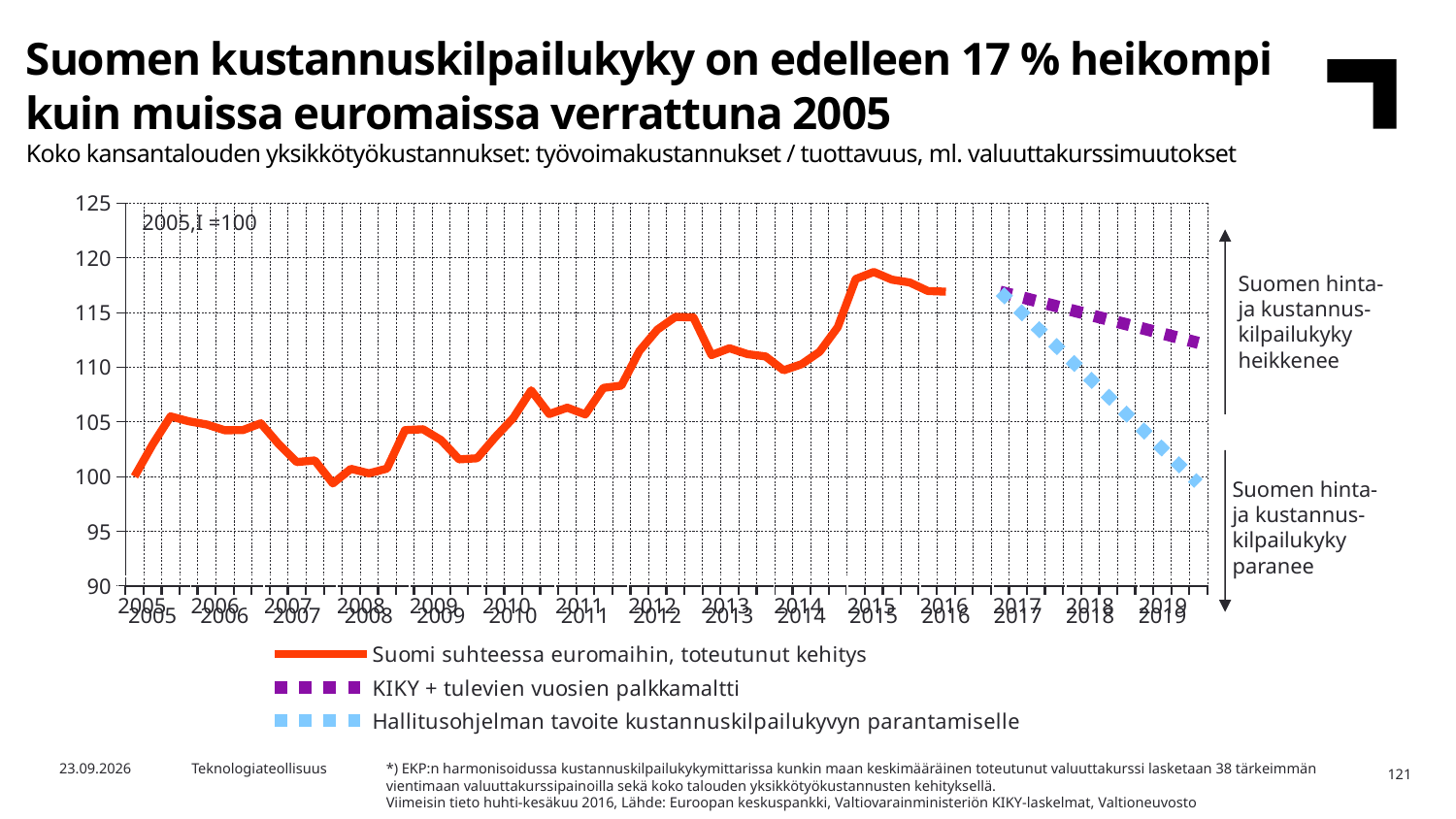
In which year does the red line 'Suomi suhteessa euromaihin, toteutunut kehitys' reach its highest value? 2015 Which is larger for the red line 'Suomi suhteessa euromaihin, toteutunut kehitys': the value in 2010 or the value in 2015? 2015 What is the index value of the series 'Suomi suhteessa euromaihin, toteutunut kehitys' at the start of 2005? 100 Which legend entry is drawn as a solid red line? Suomi suhteessa euromaihin, toteutunut kehitys Is the end value of the light blue dashed series 'Hallitusohjelman tavoite kustannuskilpailukyvyn parantamiselle' in 2019 greater or less than 105? less How many series does the legend list? 3 Is the end value of the purple dashed series 'KIKY + tulevien vuosien palkkamaltti' in 2019 greater or less than 110? greater What kind of chart is shown on the slide? line chart Is the value of the red line 'Suomi suhteessa euromaihin, toteutunut kehitys' in 2009 greater or less than 105? less Does the light blue dashed series 'Hallitusohjelman tavoite kustannuskilpailukyvyn parantamiselle' rise or fall from 2017 to 2019? fall How many years are labelled on the x axis? 15